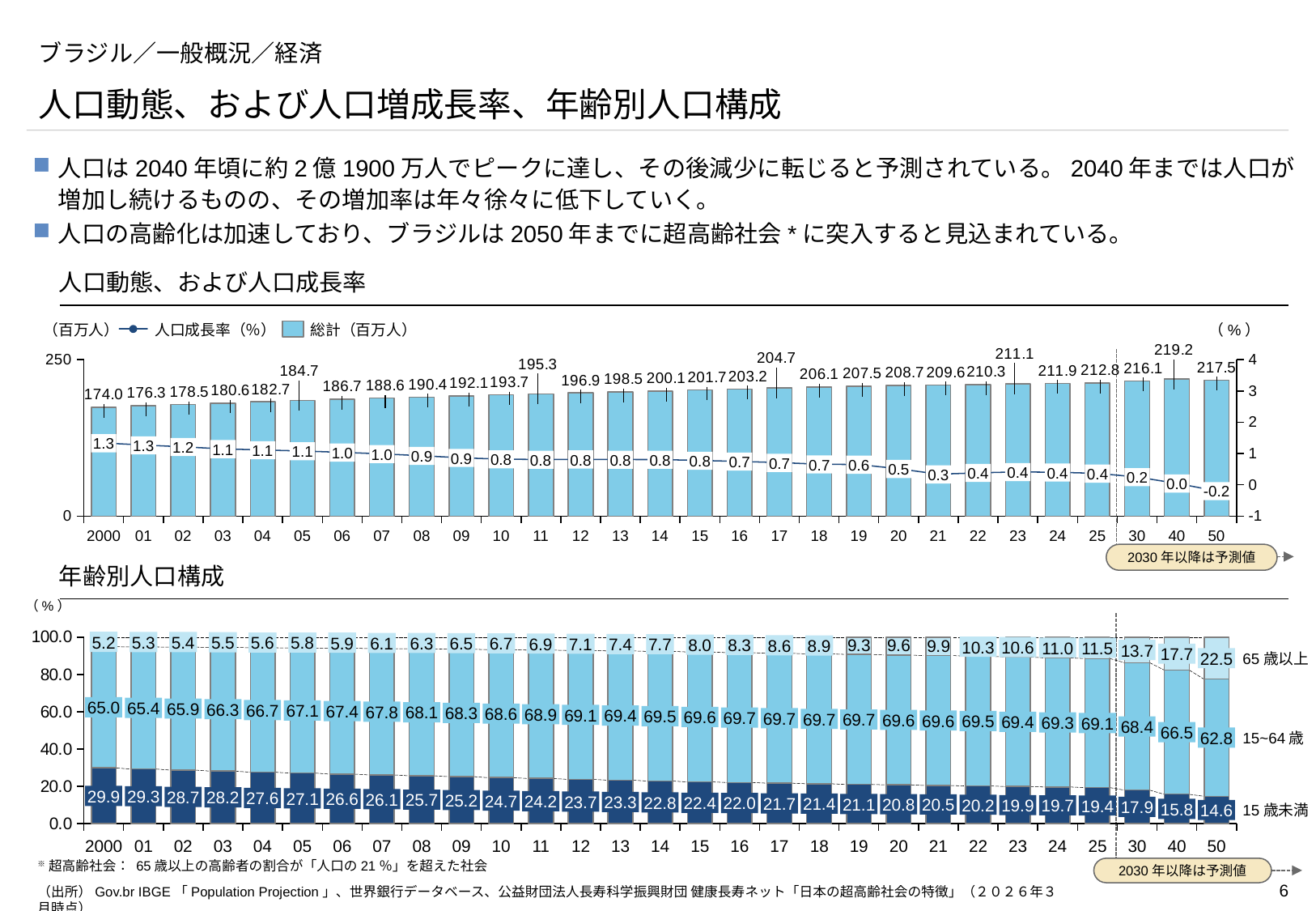
In the top chart (人口動態、および人口成長率), does the population growth rate line rise or fall from 2000 to 2050? fall In the top chart (人口動態、および人口成長率), how many years are shown on the x axis? 29 In the top chart (人口動態、および人口成長率), what is the total population (百万人) shown for 2040? 219.2 What kind of chart is the bottom chart (年齢別人口構成)? stacked bar chart In the bottom chart (年齢別人口構成), is the share of 15~64歳 larger in 2017 or in 2050? 2017 In the top chart (人口動態、および人口成長率), what is the difference between the total population in 2050 and in 2000? 43.5 In the bottom chart (年齢別人口構成), what is the share of 65歳以上 in 2050? 22.5 In the bottom chart (年齢別人口構成), what is the share of 15歳未満 in 2000? 29.9 In the top chart (人口動態、および人口成長率), what is the population growth rate (%) shown for 2050? -0.2 In the bottom chart (年齢別人口構成), which year has the lowest share of 15歳未満? 2050 In the top chart (人口動態、および人口成長率), which year has the highest total population bar? 2040 In the top chart (人口動態、および人口成長率), how many series does the legend list? 2